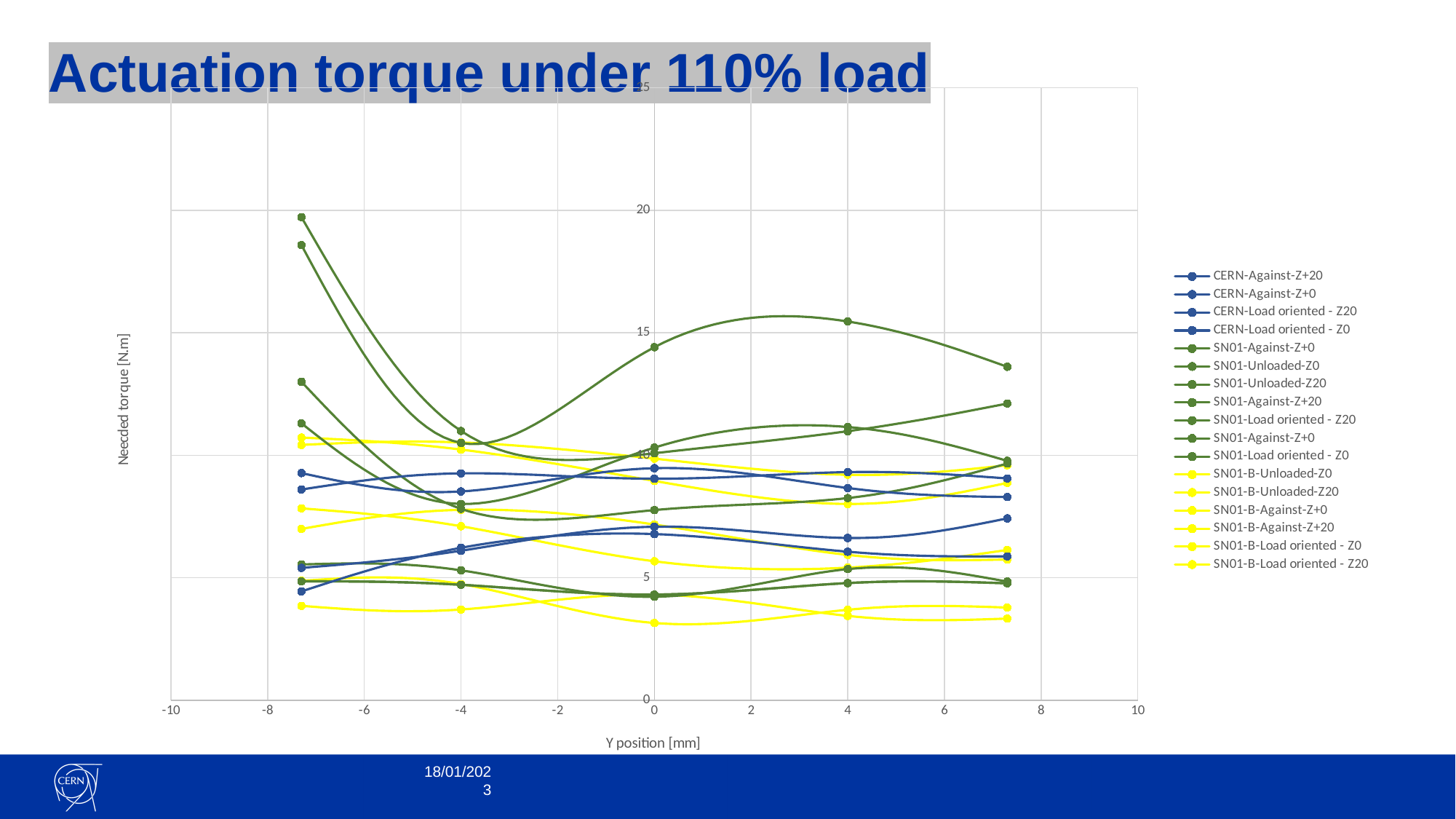
What is the title of the slide containing the chart? Actuation torque under 110% load Is the highest plotted torque value on the chart greater or less than 15? greater How many series does the chart's legend list? 17 Is the lowest plotted torque value on the chart greater or less than 5? less What is the label of the chart's y axis? Needed torque [N.m] What is the lowest tick value shown on the chart's x axis? -10 How many Y positions (data points per series) are plotted along the x axis? 5 What kind of chart is shown on the slide? line chart